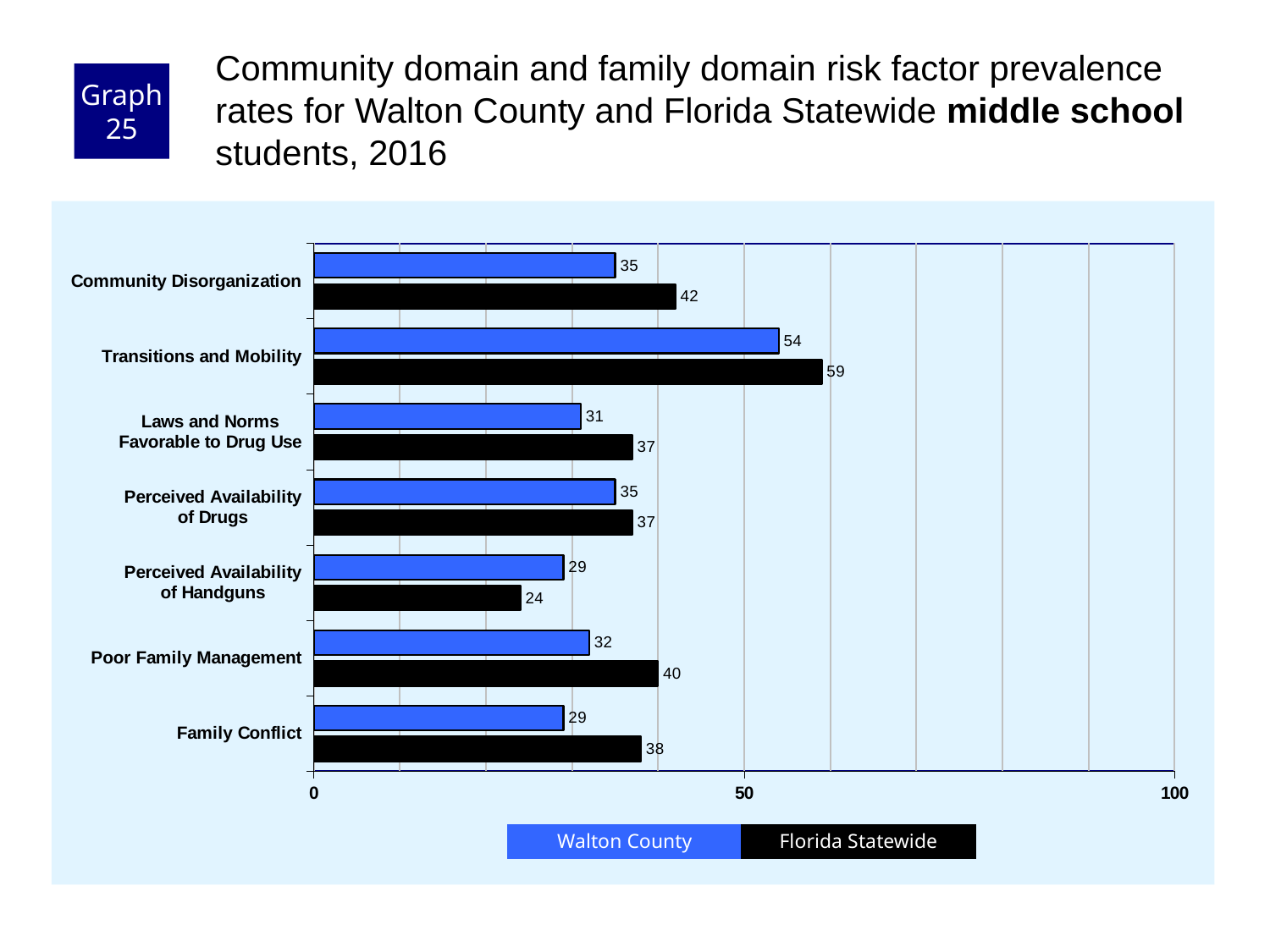
What is the Florida Statewide value for Perceived Availability of Handguns? 24 Is the Florida Statewide value for Transitions and Mobility greater or less than 50? greater Which risk factor has the lowest Florida Statewide value? Perceived Availability of Handguns What is the Walton County value for Transitions and Mobility? 54 What is the Florida Statewide value for Poor Family Management? 40 Which risk factor has the highest Walton County value? Transitions and Mobility Which colour represents Florida Statewide in the chart? Black Which is larger for Perceived Availability of Handguns: the Walton County value or the Florida Statewide value? Walton County What kind of chart is shown on the slide? Bar chart What is the difference between the Florida Statewide and Walton County values for Family Conflict? 9 How many risk factor categories are shown on the chart? 7 How many series does the legend list? 2